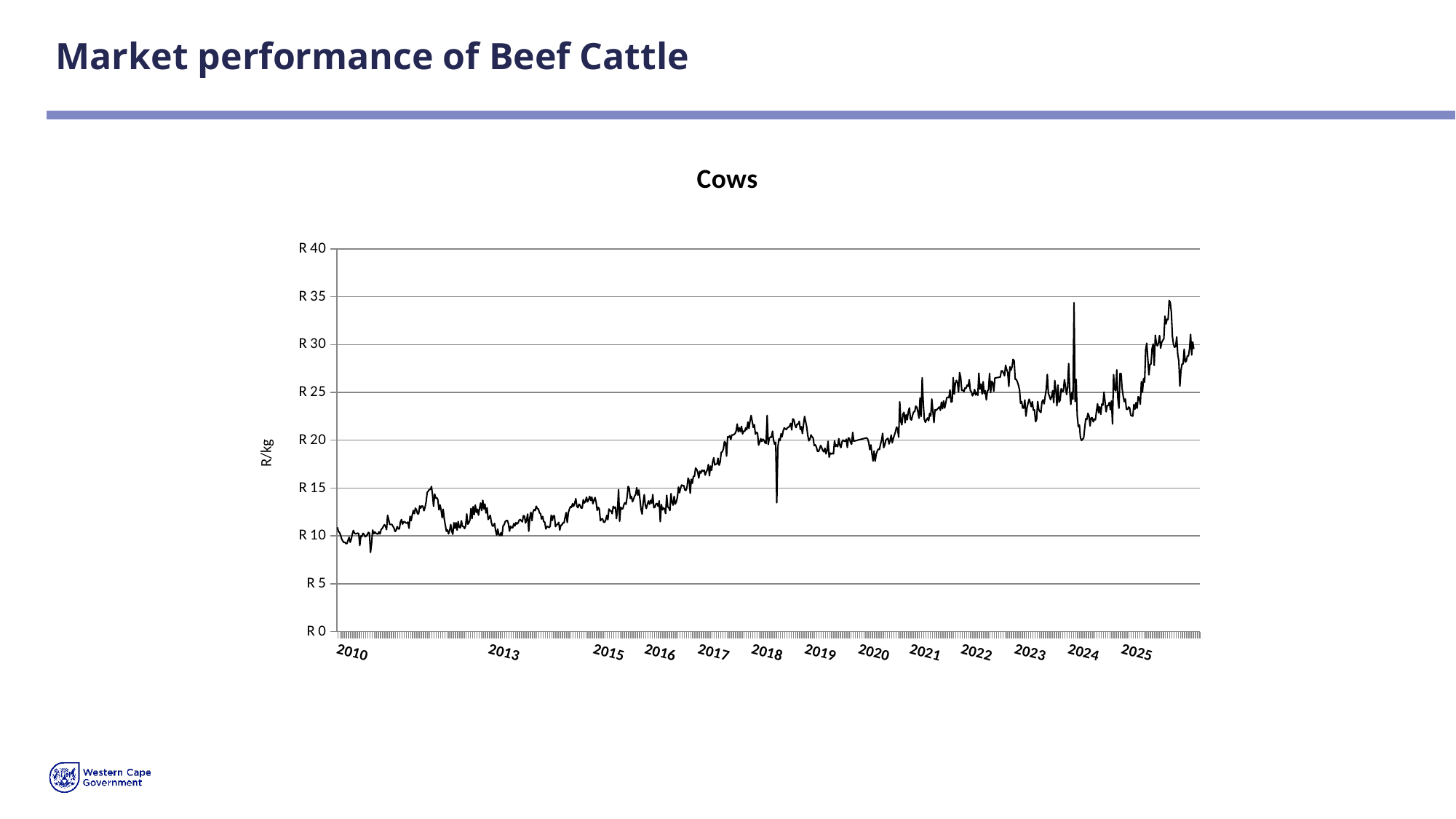
What is the title of the chart? Cows What is the label on the vertical axis of the chart? R/kg Is the value for 2010 greater or less than R 15? less Which year has the lowest values on the chart? 2010 Which is larger, the value for 2025 or the value for 2013? 2025 Is the value for 2013 greater or less than R 15? less How many year labels are shown on the x axis? 13 Overall, do the values rise or fall from 2010 to 2025? rise Is the value for 2017 greater or less than R 15? greater What kind of chart is shown on the slide? line chart